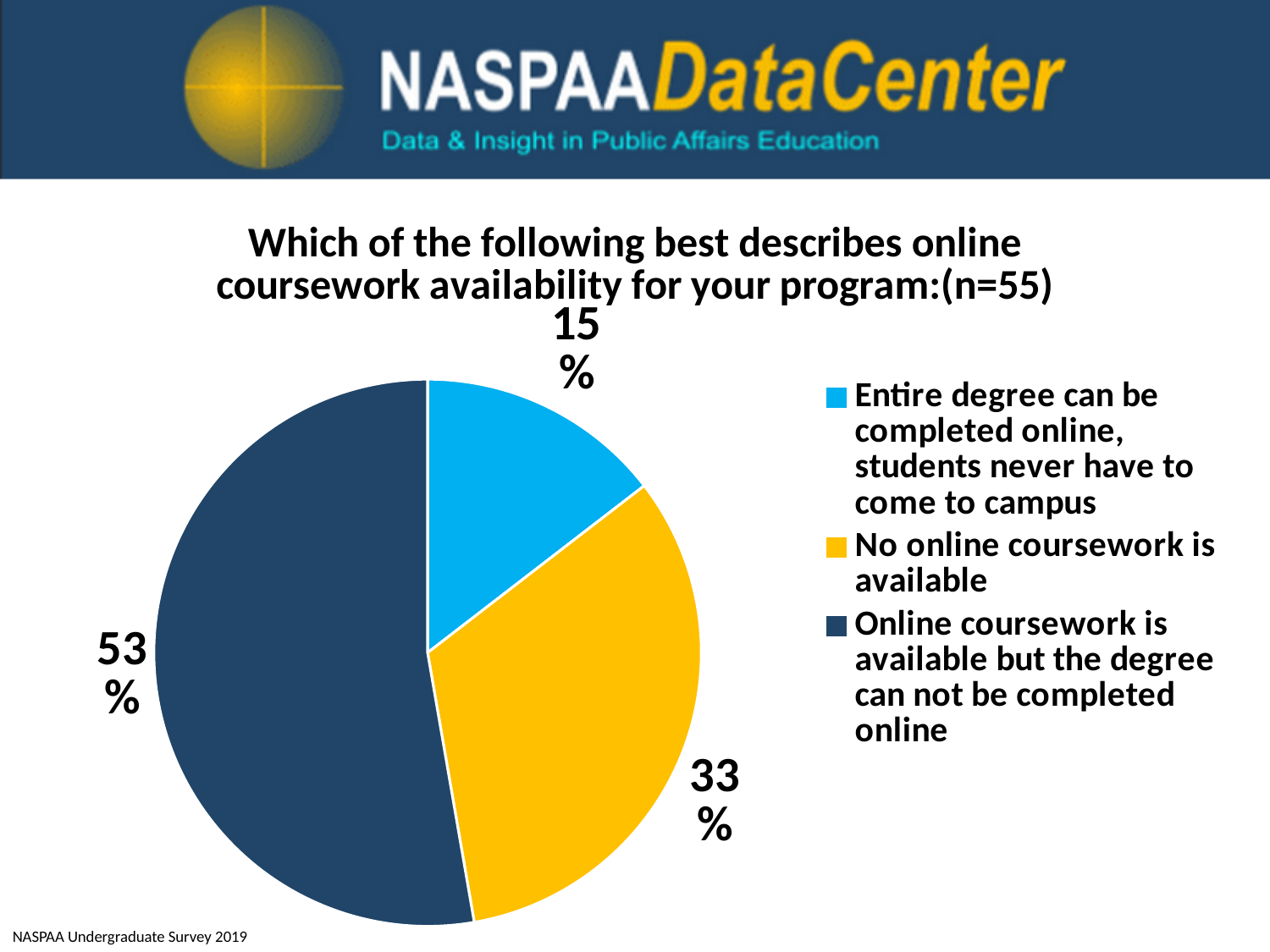
What percentage of programs report that no online coursework is available? 33% What percentage of programs report that the entire degree can be completed online? 15% Which is larger: the share for 'No online coursework is available' or the share for 'Entire degree can be completed online'? No online coursework is available How many slices does the pie chart have? 3 What percentage of programs report that online coursework is available but the degree can not be completed online? 53% Which response has the largest share of the pie? Online coursework is available but the degree can not be completed online What kind of chart is shown on the slide? pie chart What colour is the slice for 'No online coursework is available'? yellow Which response has the smallest share of the pie? Entire degree can be completed online, students never have to come to campus What is the sample size (n) given in the chart title? 55 How many entries does the legend list? 3 What is the difference in percentage points between 'No online coursework is available' and 'Entire degree can be completed online'? 18